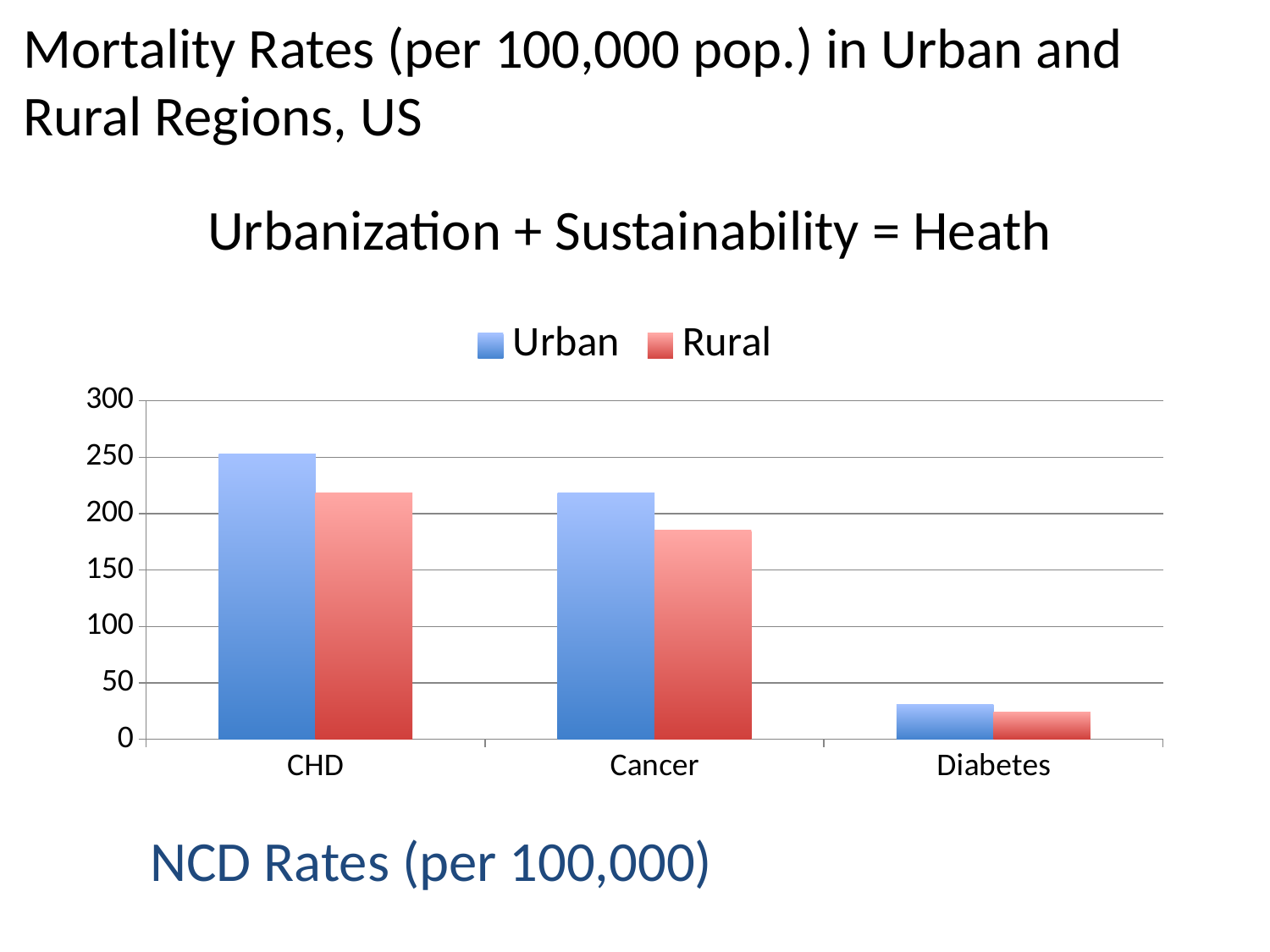
Do the Urban values rise or fall from CHD to Diabetes along the x axis? fall What colour are the Rural bars? red What kind of chart is shown on the slide? bar chart How many series does the legend list? 2 Is the Urban value for CHD greater or less than 200? greater Which category has the highest Urban value? CHD Which category has the lowest Rural value? Diabetes Is the Rural value for Cancer greater or less than 200? less How many categories are shown on the x axis? 3 For CHD, which is larger, the Urban value or the Rural value? Urban For Cancer, which is larger, the Urban value or the Rural value? Urban Is the Urban value for Diabetes greater or less than 50? less